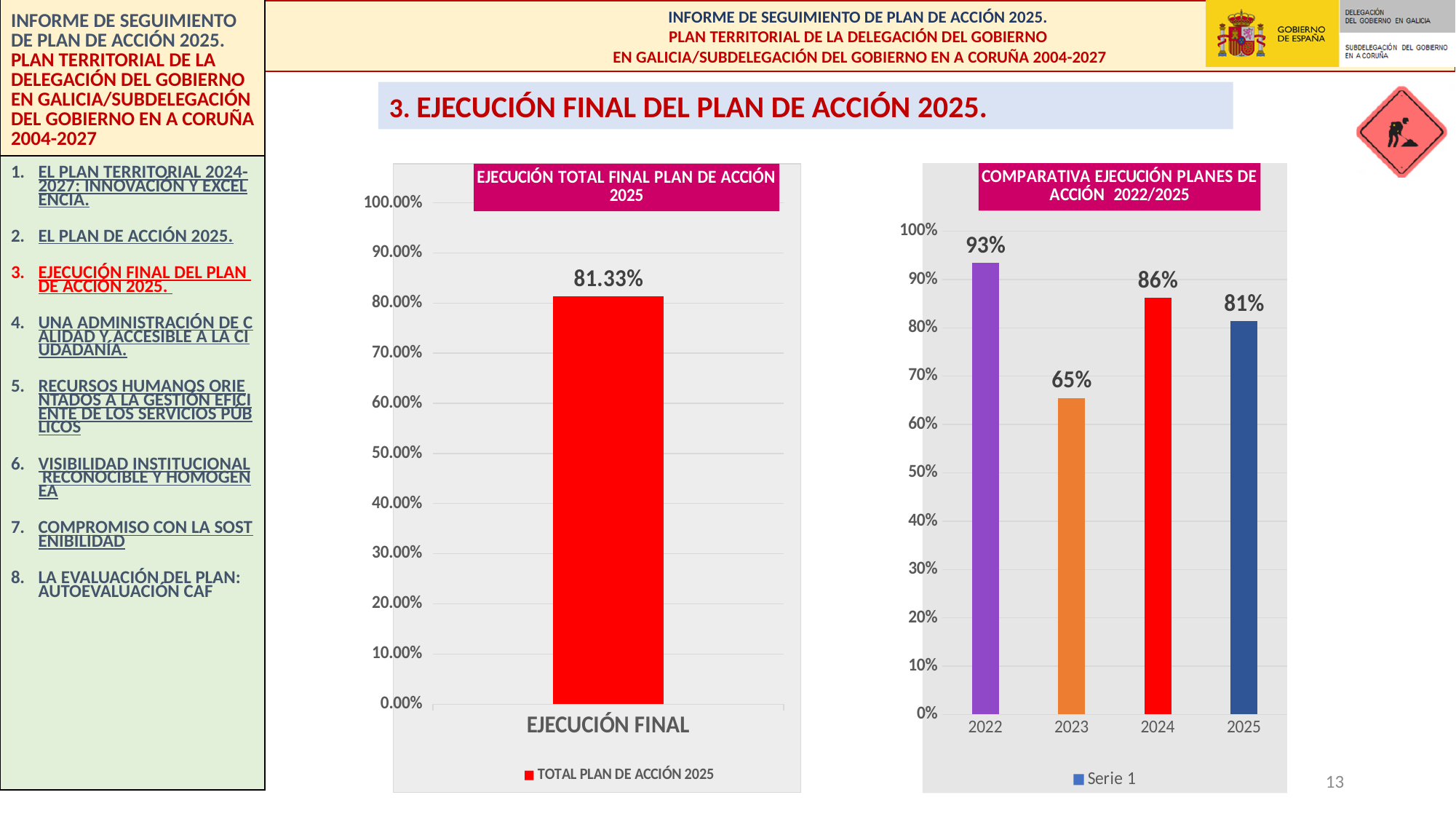
In the chart titled 'EJECUCIÓN TOTAL FINAL PLAN DE ACCIÓN 2025', what series name does the legend show? TOTAL PLAN DE ACCIÓN 2025 In the chart titled 'COMPARATIVA EJECUCIÓN PLANES DE ACCIÓN 2022/2025', what is the value for 2023? 65% In the chart titled 'COMPARATIVA EJECUCIÓN PLANES DE ACCIÓN 2022/2025', which year has the lowest value? 2023 In the chart titled 'COMPARATIVA EJECUCIÓN PLANES DE ACCIÓN 2022/2025', which is larger, the value for 2024 or the value for 2025? 2024 In the chart titled 'EJECUCIÓN TOTAL FINAL PLAN DE ACCIÓN 2025', what is the value shown for EJECUCIÓN FINAL? 81.33% In the chart titled 'COMPARATIVA EJECUCIÓN PLANES DE ACCIÓN 2022/2025', what colour is the bar for 2023? Orange In the chart titled 'EJECUCIÓN TOTAL FINAL PLAN DE ACCIÓN 2025', what kind of chart is shown? Bar chart In the chart titled 'COMPARATIVA EJECUCIÓN PLANES DE ACCIÓN 2022/2025', how many years are plotted? 4 In the chart titled 'COMPARATIVA EJECUCIÓN PLANES DE ACCIÓN 2022/2025', which year has the highest value? 2022 In the chart titled 'COMPARATIVA EJECUCIÓN PLANES DE ACCIÓN 2022/2025', how many series does the legend list? 1 In the chart titled 'COMPARATIVA EJECUCIÓN PLANES DE ACCIÓN 2022/2025', what is the value for 2024? 86% In the chart titled 'COMPARATIVA EJECUCIÓN PLANES DE ACCIÓN 2022/2025', what is the difference between the values for 2022 and 2025? 12%